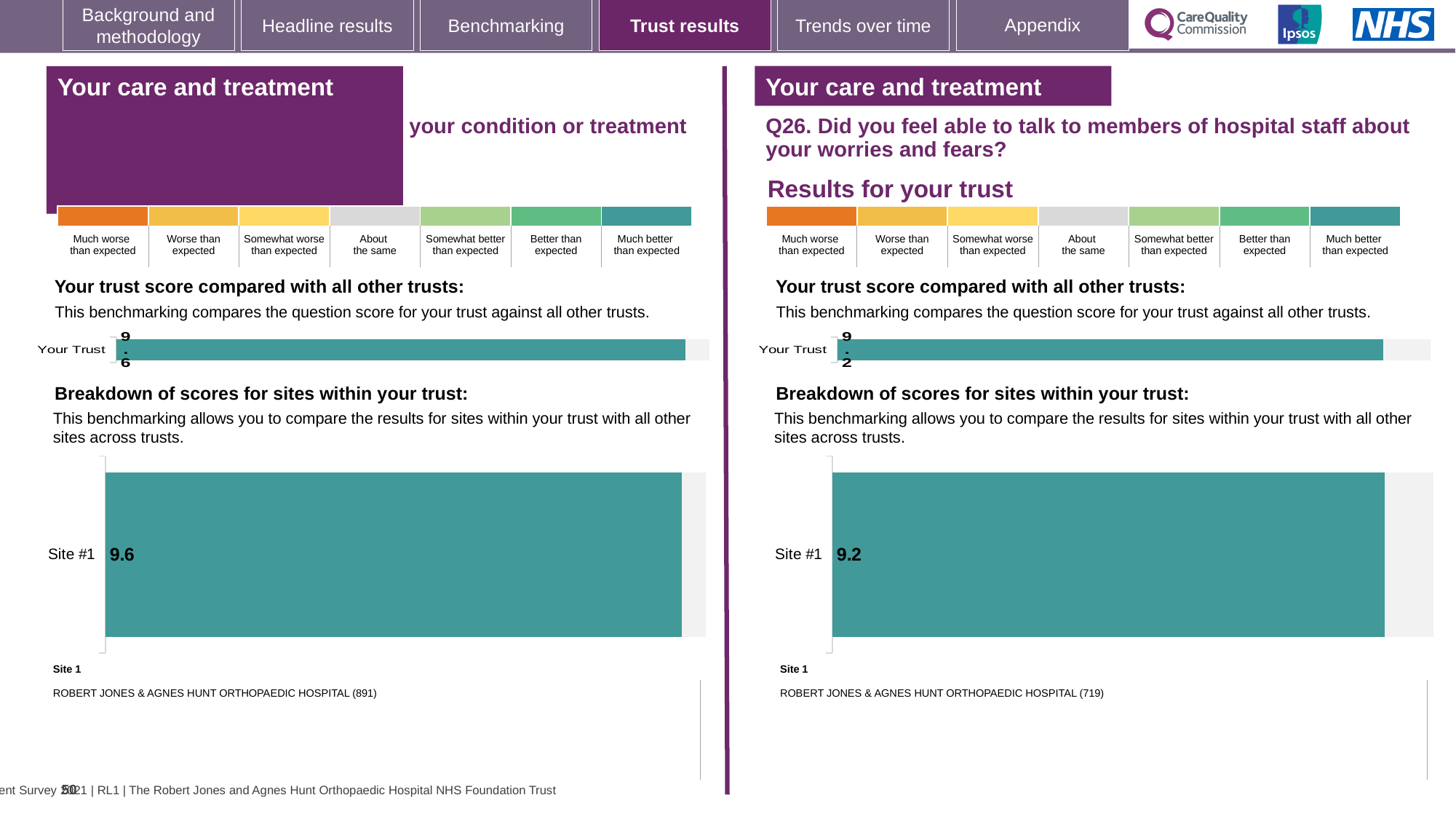
What is the difference between the Site #1 score in the left-hand chart and the Site #1 score in the right-hand (Q26) chart? 0.4 In the left-hand 'Your trust score compared with all other trusts' chart, what is the value for Your Trust? 9.6 What kind of chart is used for the 'Breakdown of scores for sites within your trust' on the right-hand side? Bar chart How many categories are plotted in the left-hand 'Your trust score compared with all other trusts' chart? 1 Is the Your Trust value in the right-hand (Q26) chart greater or less than 9.6? less Which hospital is listed as Site 1 beneath the right-hand (Q26) breakdown chart? ROBERT JONES & AGNES HUNT ORTHOPAEDIC HOSPITAL (719) In the left-hand 'Breakdown of scores for sites within your trust' chart, what is the score for Site #1? 9.6 In the right-hand (Q26) 'Your trust score compared with all other trusts' chart, what is the value for Your Trust? 9.2 In the right-hand (Q26) 'Breakdown of scores for sites within your trust' chart, what is the score for Site #1? 9.2 How many sites are shown in the right-hand (Q26) 'Breakdown of scores for sites within your trust' chart? 1 What colour is the Site #1 bar in the right-hand (Q26) breakdown chart? Teal Comparing the Site #1 bars, which side of the slide shows the larger score: the left-hand chart or the right-hand (Q26) chart? Left-hand chart